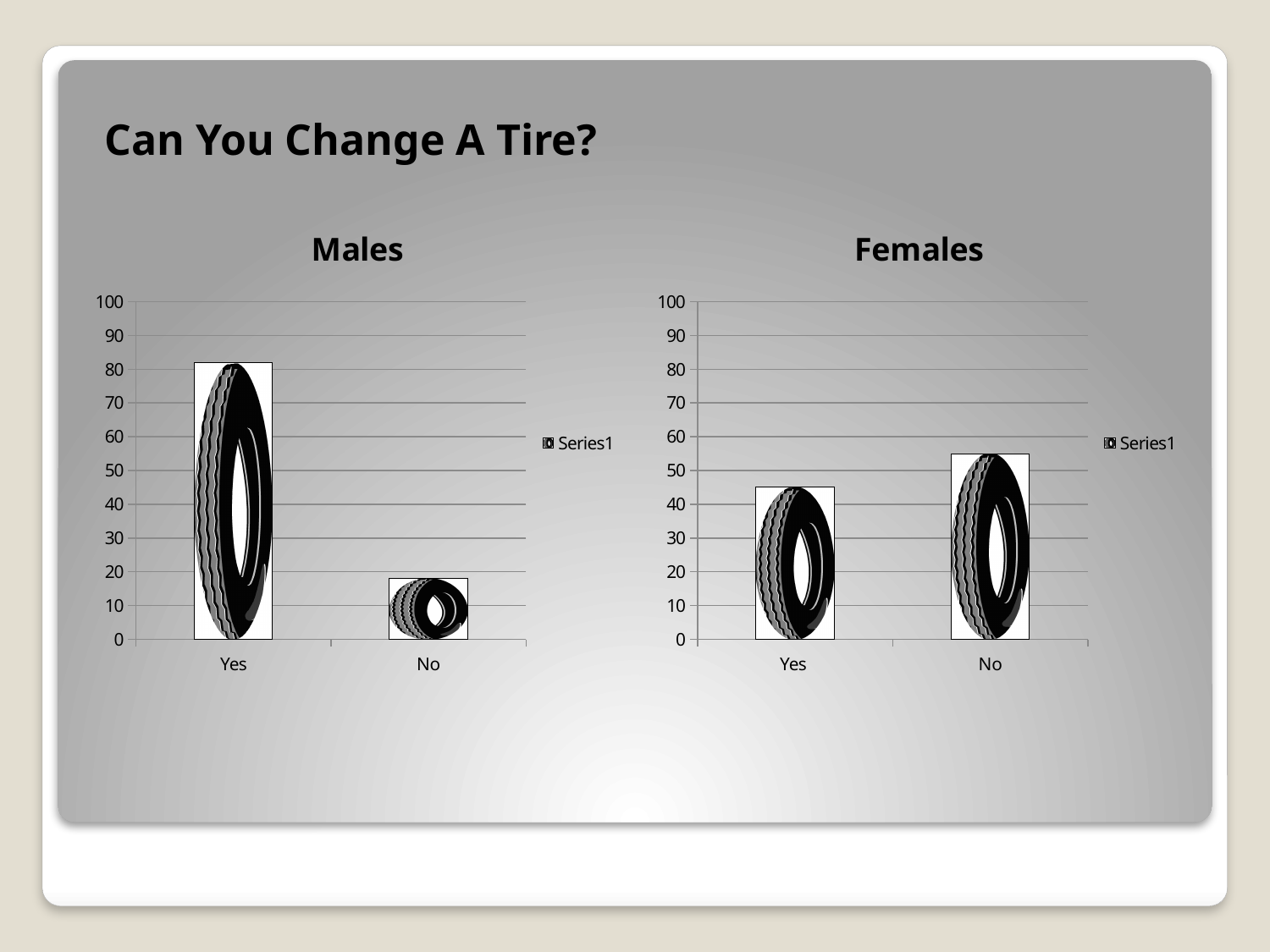
In the Males chart, which category has the lowest value? No What kind of chart is the Females chart? bar chart In the Females chart, is the value for No greater or less than 40? greater In the Males chart, which category has the highest value? Yes In the Females chart, which category has the lowest value? Yes In the Females chart, is the value for Yes greater or less than 60? less How many series does the legend of the Males chart list? 1 How many categories are shown on the x axis of the Males chart? 2 In the Males chart, is the value for Yes greater or less than 70? greater In the Females chart, which is larger, the value for Yes or the value for No? No In the Females chart, which category has the highest value? No